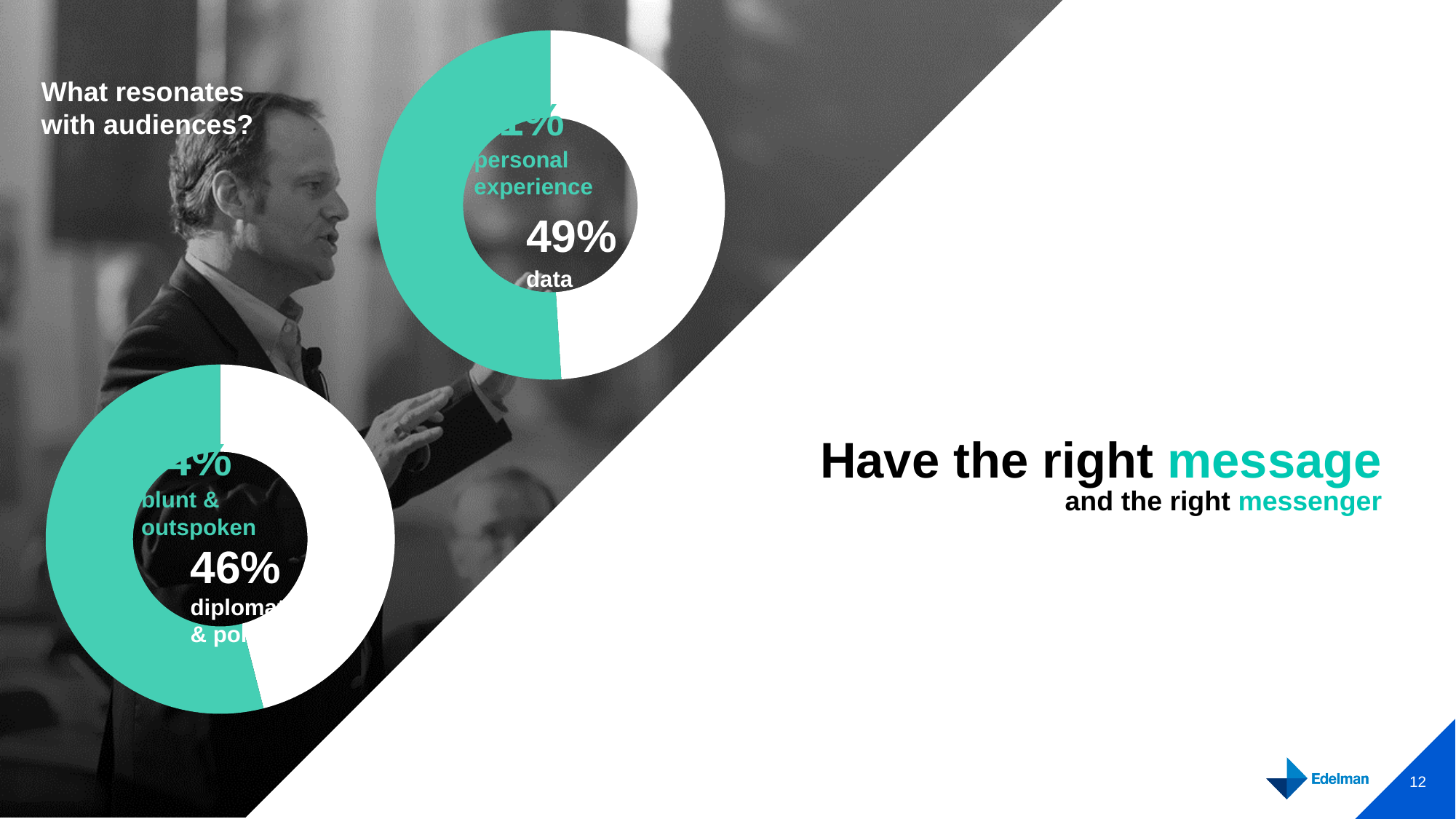
In the bottom donut chart, is the share for blunt & outspoken greater or less than 50%? greater How many segments does the top donut chart have? 2 In the top donut chart, what percentage is shown for data? 49% What question is posed as the heading above the charts? What resonates with audiences? What kind of chart is used on this slide? Donut (pie) chart In the bottom donut chart, what percentage is shown for the white segment? 46% In the top donut chart, is the share for data greater or less than 50%? less In the top donut chart, what colour is the personal experience segment? Teal In the bottom donut chart, which segment is larger: blunt & outspoken or the white segment? blunt & outspoken How many donut charts are on the slide? 2